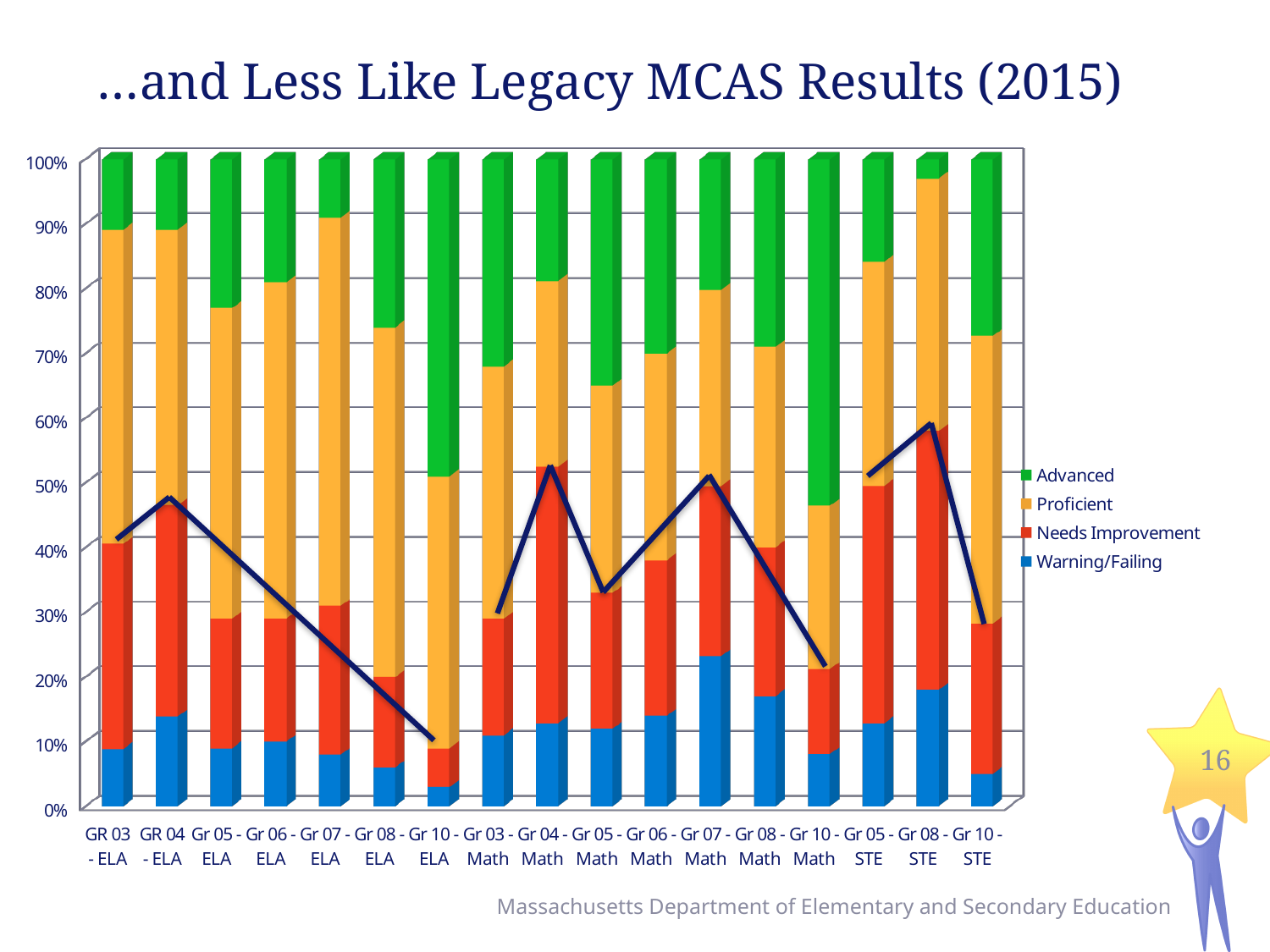
Which category has the largest Warning/Failing segment? Gr 07 - Math Which category has the smallest Warning/Failing segment? Gr 10 - ELA How many series does the chart's legend list? 4 Which category has the smallest Advanced segment? Gr 08 - STE How many categories are shown along the x axis of the chart? 17 What is the title of the slide containing the chart? ...and Less Like Legacy MCAS Results (2015) What is the total of the stacked bar for GR 03 - ELA? 100% Is the Advanced value for Gr 10 - ELA greater or less than 40%? greater Which has the larger Warning/Failing segment, Gr 08 - Math or GR 03 - ELA? Gr 08 - Math Is the Warning/Failing value for Gr 07 - Math greater or less than 20%? greater What kind of chart is shown on the slide? Stacked bar chart What are the four series listed in the chart's legend? Advanced, Proficient, Needs Improvement, Warning/Failing